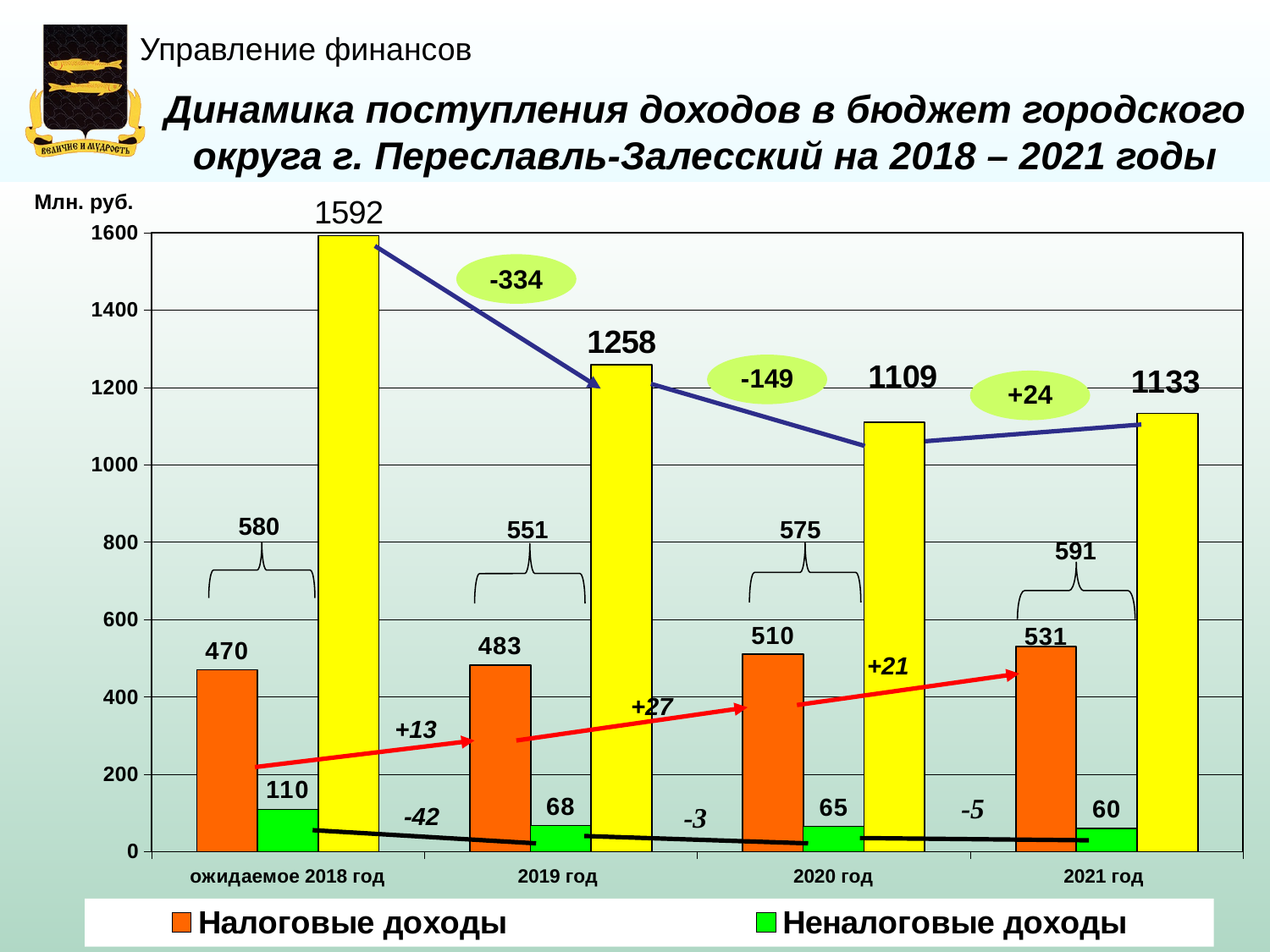
What is the value of Неналоговые доходы for ожидаемое 2018 год? 110 What is the value of Налоговые доходы for 2019 год? 483 Is the value of Налоговые доходы for 2020 год greater or less than 400? greater In which year is Налоговые доходы highest? 2021 год Which is larger: the yellow bar for 2020 год or the yellow bar for 2021 год? 2021 год How many year categories are shown on the x axis? 4 What value is labelled on the tallest yellow bar, for ожидаемое 2018 год? 1592 What kind of chart is shown on the slide? bar chart How many series does the legend list? 2 Do the values of Неналоговые доходы rise or fall from 2018 to 2021? fall In which year is Неналоговые доходы lowest? 2021 год What is the difference between Налоговые доходы in 2021 год and in 2020 год? 21